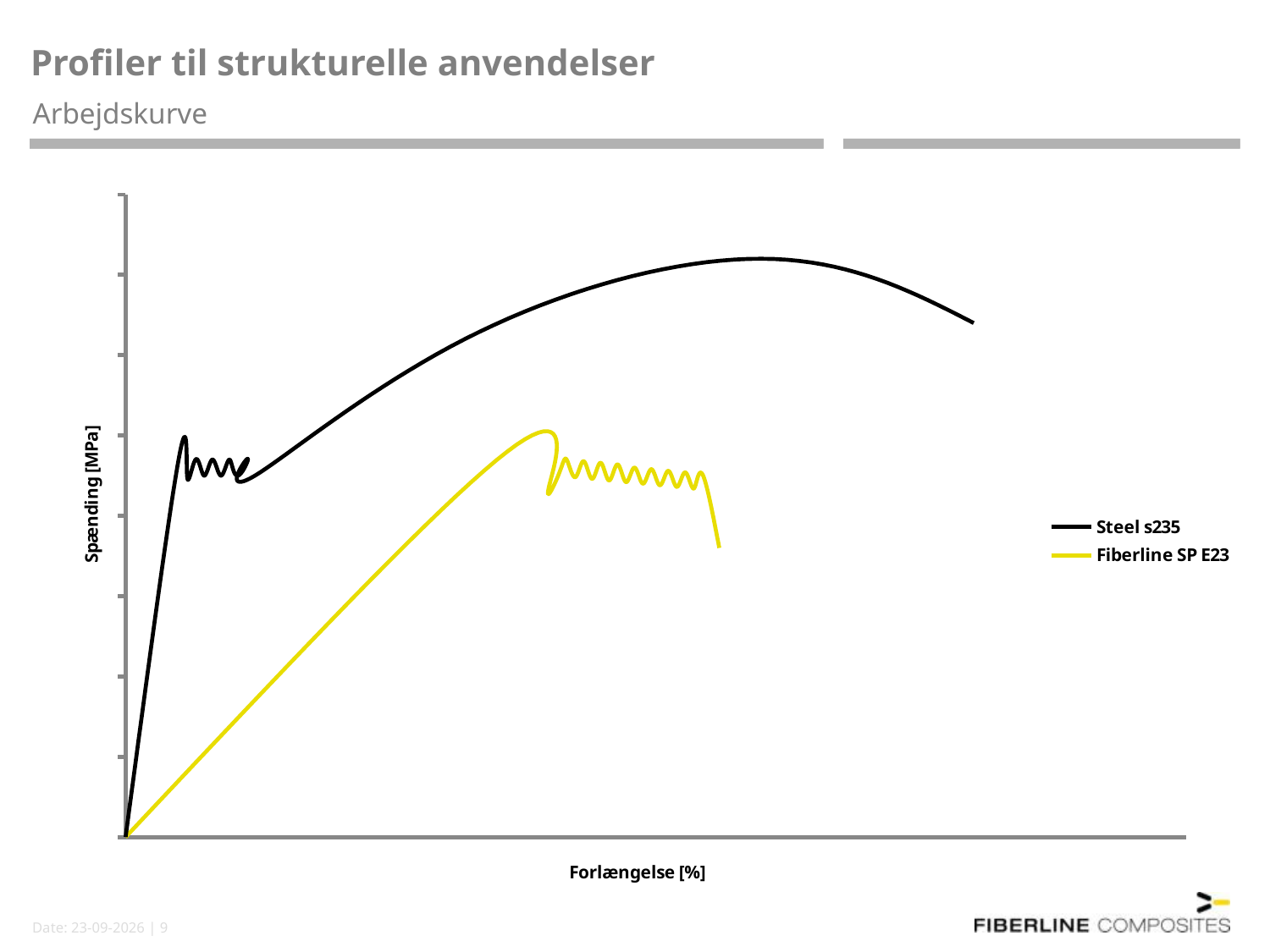
Which series extends to the larger elongation along the x axis? Steel s235 Does the Fiberline SP E23 curve rise or fall at the start of the x axis? rise Which series reaches the higher peak stress, Steel s235 or Fiberline SP E23? Steel s235 What is the label of the x axis? Forlængelse [%] What is the label of the y axis? Spænding [MPa] What kind of chart is shown on the slide? line chart How many series does the legend list? 2 Which series reaches the lower maximum stress? Fiberline SP E23